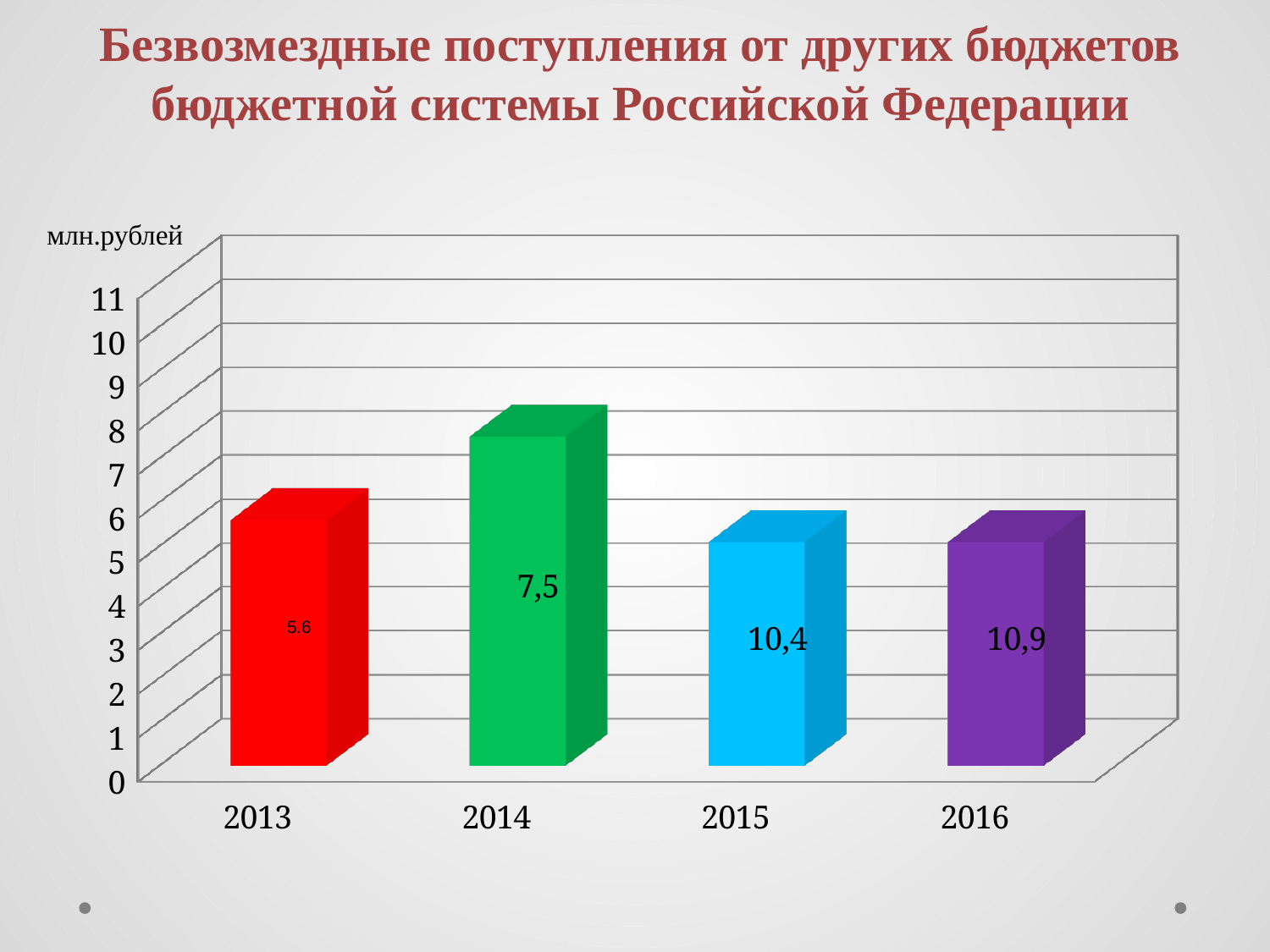
According to the data labels, which year has the highest value? 2016 According to the data labels, which year has the lowest value? 2013 How many years are shown on the x axis? 4 What unit is indicated above the vertical axis? млн.рублей What is the value shown for 2015? 10,4 Which labelled value is larger, 2014 or 2013? 2014 By how much does the labelled value for 2016 exceed the labelled value for 2015? 0,5 What is the value shown for 2014? 7,5 What is the difference between the labelled values for 2015 and 2014? 2,9 What is the value shown for 2016? 10,9 What type of chart is shown on the slide? Bar chart What is the data label on the bar for 2013? 5.6